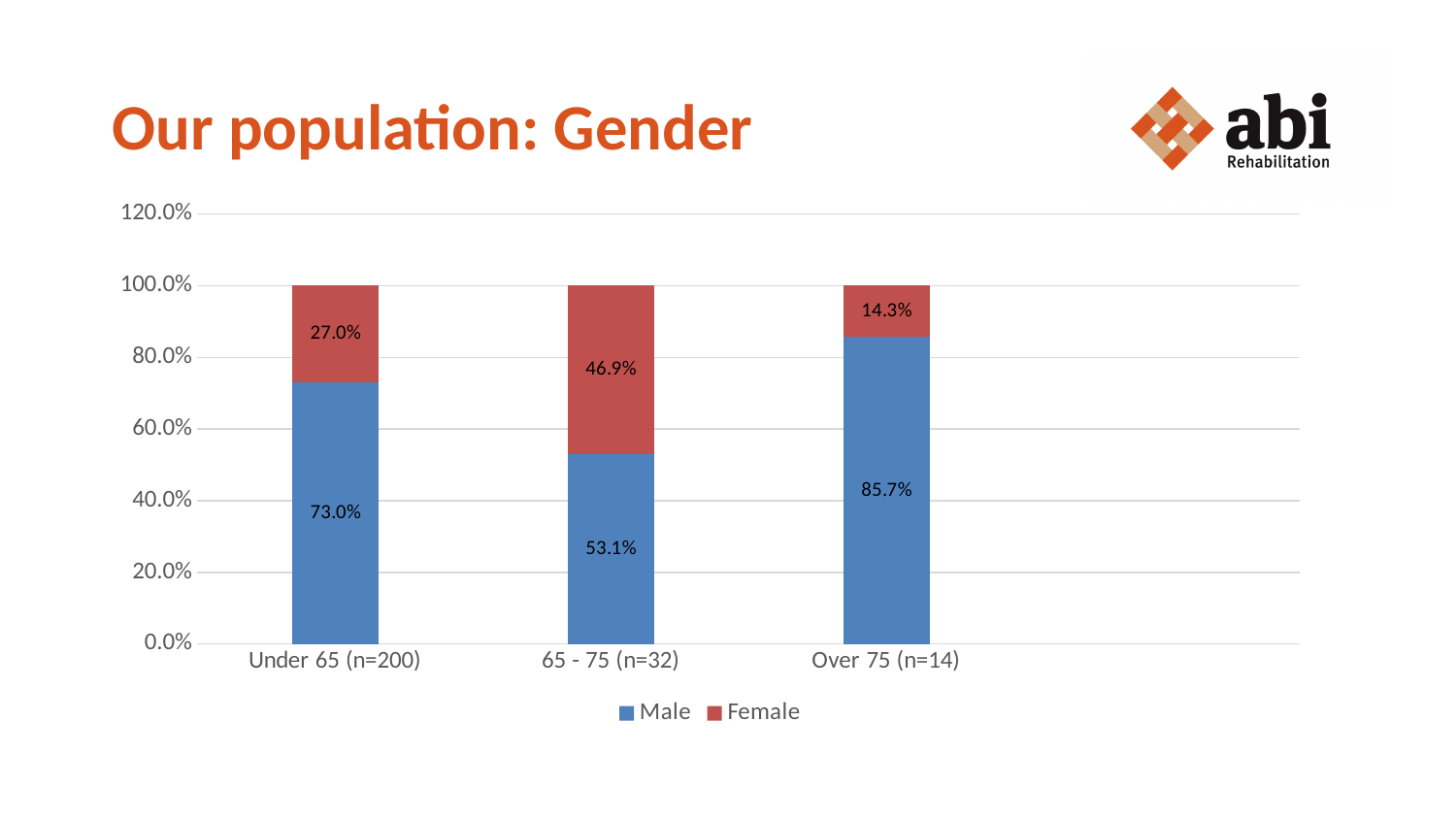
What is the Male percentage for the Over 75 (n=14) group? 85.7% What is the Female percentage for the 65 - 75 (n=32) group? 46.9% How many series does the legend list? 2 Is the Female percentage larger for the Under 65 (n=200) group or the 65 - 75 (n=32) group? 65 - 75 (n=32) How many age groups are shown on the x axis? 3 What is the Male percentage for the Under 65 (n=200) group? 73.0% What is the difference between the Male and Female percentages in the 65 - 75 (n=32) group? 6.2% Which age group has the lowest Female percentage? Over 75 (n=14) Which age group has the highest Male percentage? Over 75 (n=14) Which colour represents Female in the chart? Red Does the Male percentage rise or fall from the 65 - 75 (n=32) group to the Over 75 (n=14) group? Rise What kind of chart is shown on the slide? Stacked bar chart